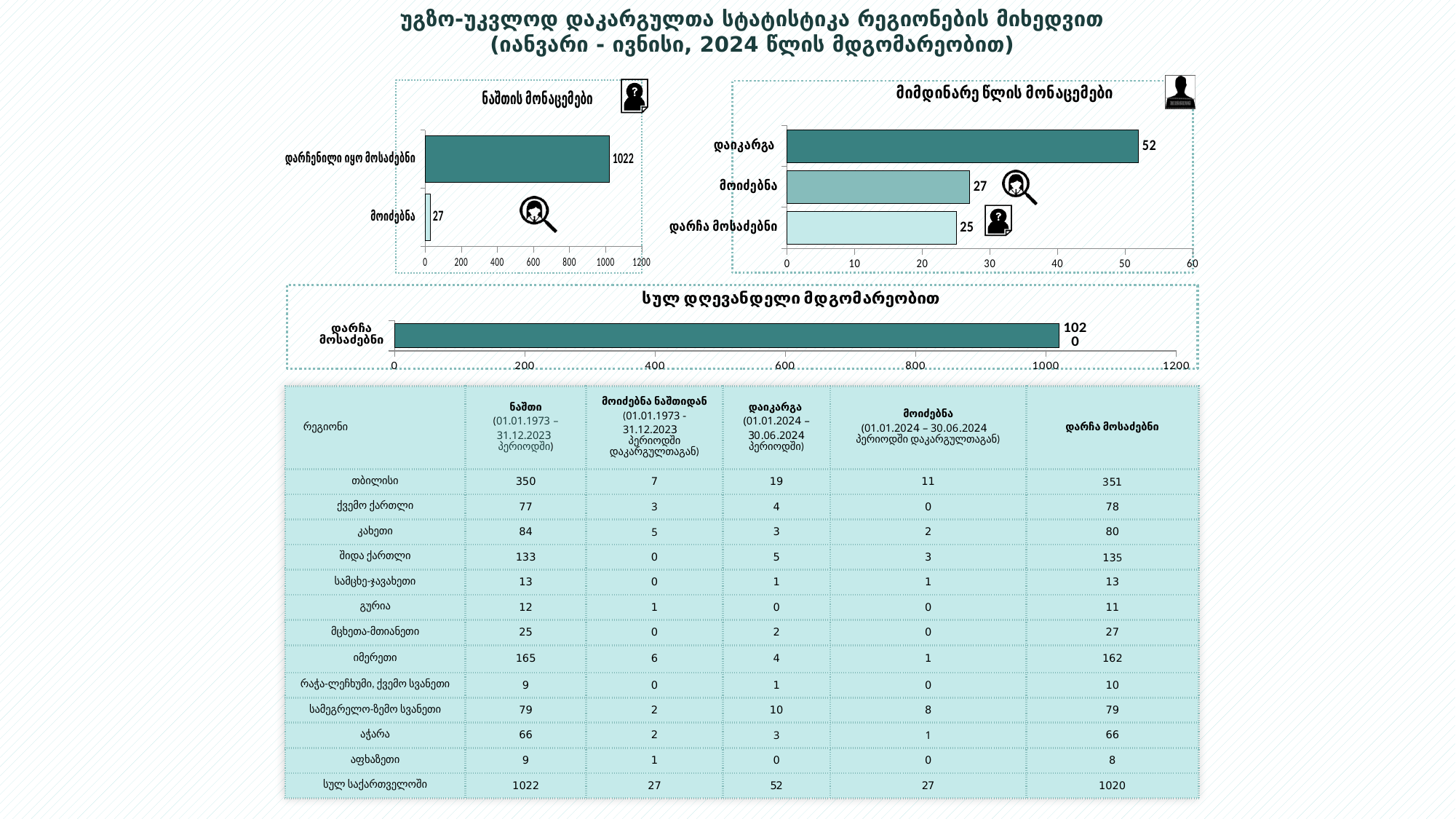
In the top-left chart titled "ნაშთის მონაცემები", what is the value for "მოიძებნა"? 27 In the top-right chart titled "მიმდინარე წლის მონაცემები", which category has the highest value? დაიკარგა In the top-left chart titled "ნაშთის მონაცემები", is the value for "დარჩენილი იყო მოსაძებნი" greater or less than 1000? greater In the top-left chart titled "ნაშთის მონაცემები", what is the difference between the values for "დარჩენილი იყო მოსაძებნი" and "მოიძებნა"? 995 In the top-right chart titled "მიმდინარე წლის მონაცემები", which category has the lowest value? დარჩა მოსაძებნი In the middle chart titled "სულ დღევანდელი მდგომარეობით", what is the value for "დარჩა მოსაძებნი"? 1020 In the top-right chart titled "მიმდინარე წლის მონაცემები", how many categories are plotted? 3 In the top-right chart titled "მიმდინარე წლის მონაცემები", what is the difference between the values for "დაიკარგა" and "მოიძებნა"? 25 In the top-left chart titled "ნაშთის მონაცემები", what is the value for "დარჩენილი იყო მოსაძებნი"? 1022 In the top-right chart titled "მიმდინარე წლის მონაცემები", what is the value for "დარჩა მოსაძებნი"? 25 In the top-right chart titled "მიმდინარე წლის მონაცემები", what is the value for "დაიკარგა"? 52 What kind of chart is the middle chart titled "სულ დღევანდელი მდგომარეობით"? bar chart